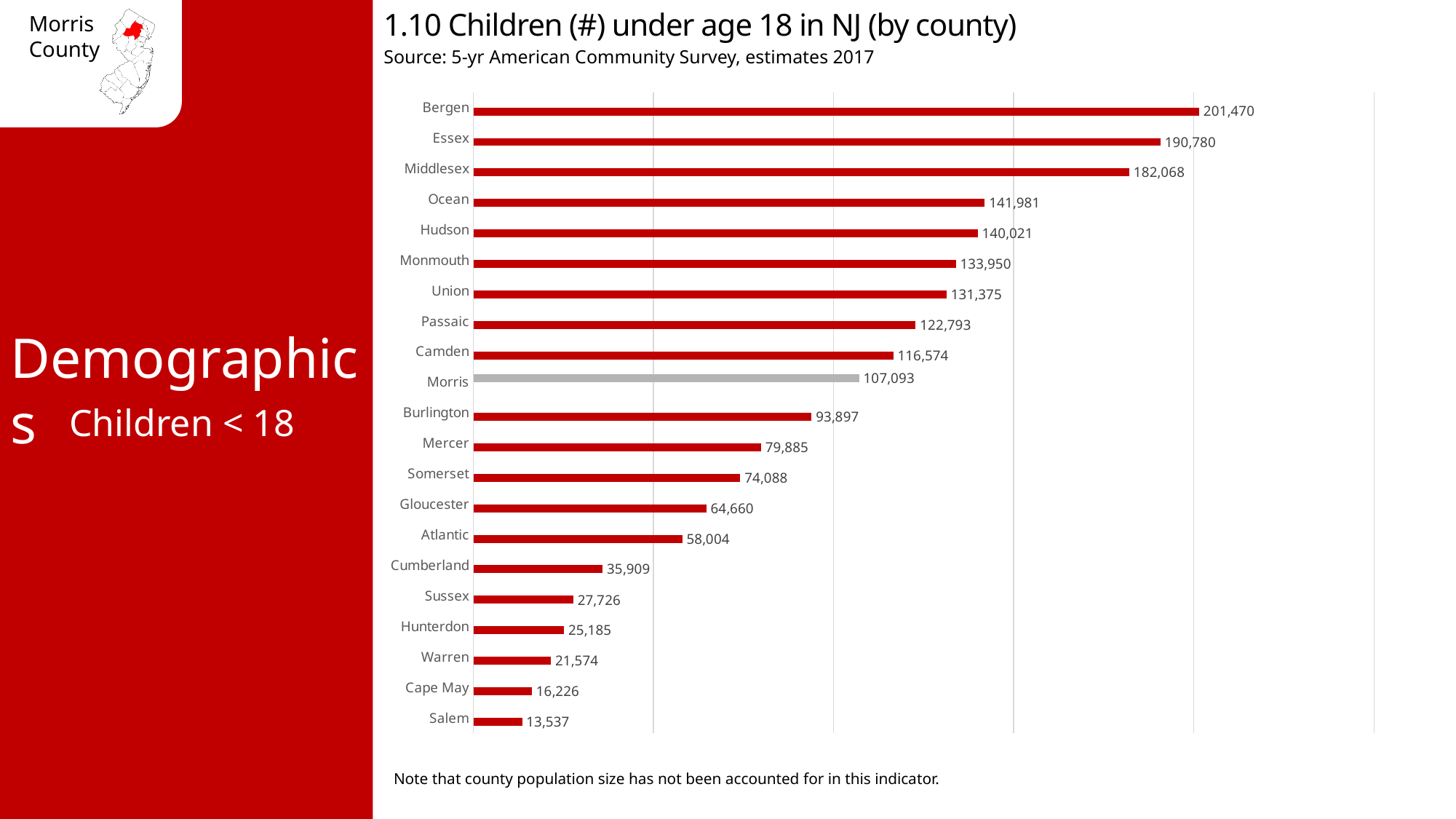
Which county has more children under age 18, Mercer or Somerset? Mercer Which county has the highest number of children under age 18? Bergen Which county has more children under age 18, Sussex or Hunterdon? Sussex How many counties are shown in the chart? 21 What type of chart is shown on the slide? bar chart What is the difference between the values for Morris and Burlington? 13,196 What is the number of children under age 18 in Morris County? 107,093 Which county has the lowest number of children under age 18? Salem What is the number of children under age 18 in Cape May County? 16,226 Which county's bar is shown in grey rather than red? Morris What is the number of children under age 18 in Middlesex County? 182,068 What is the difference between the values for Bergen and Essex? 10,690